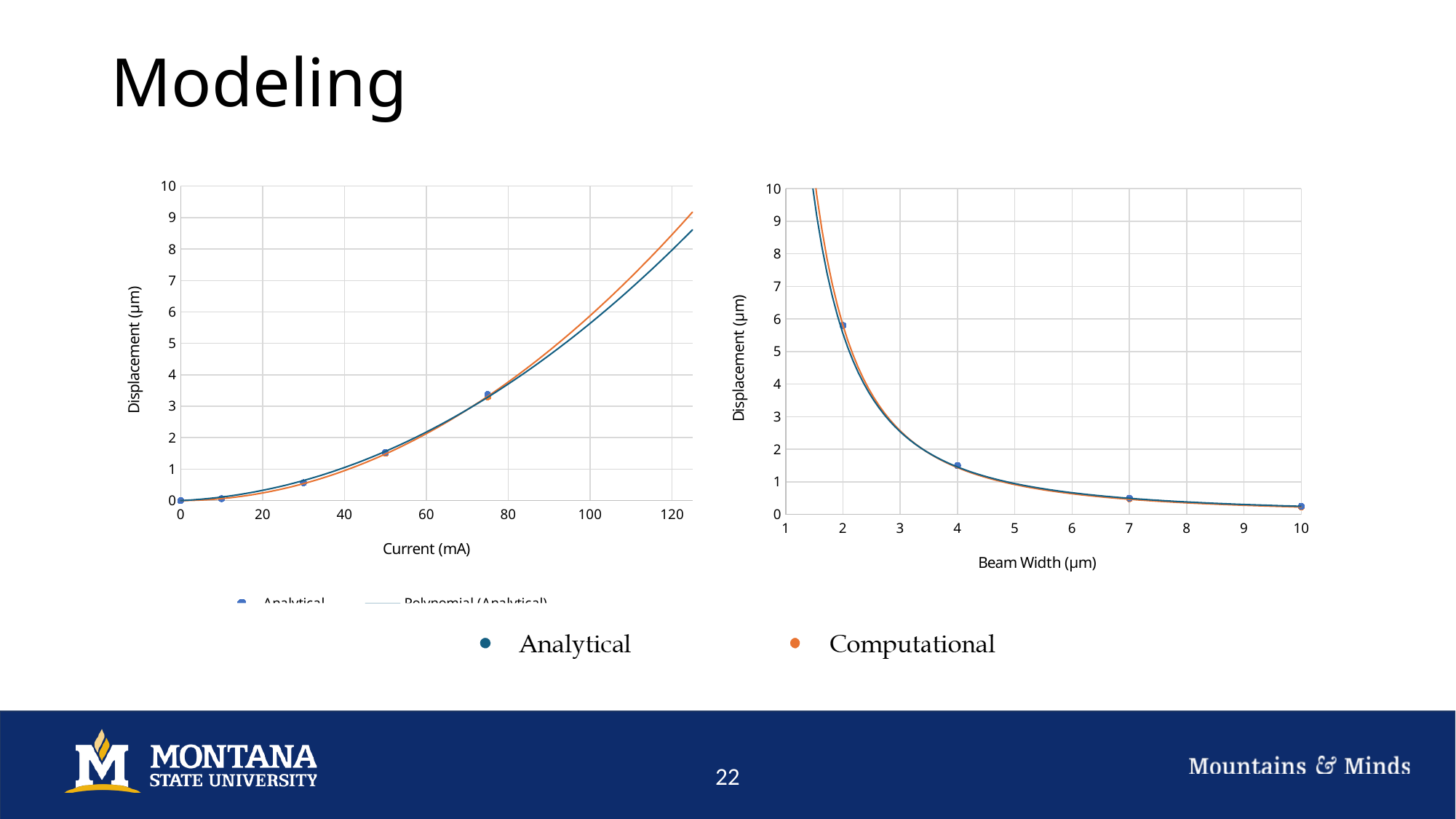
In the right chart, is the displacement at a beam width of 10 µm greater or less than 1? less In the right chart, is the displacement at a beam width of 2 µm greater or less than 5? greater Which colour represents the Computational series in the legend? orange How many series does the shared legend below the charts list? 2 In the right chart, does displacement rise or fall as beam width increases? fall In the left chart, is the displacement at 75 mA greater or less than 3? greater In the left chart, does displacement rise or fall as current increases? rise What kind of chart is the left chart (Current vs Displacement)? line chart What is the x-axis title of the right chart? Beam Width (µm) In the left chart, which series has the higher displacement at 120 mA, Analytical or Computational? Computational